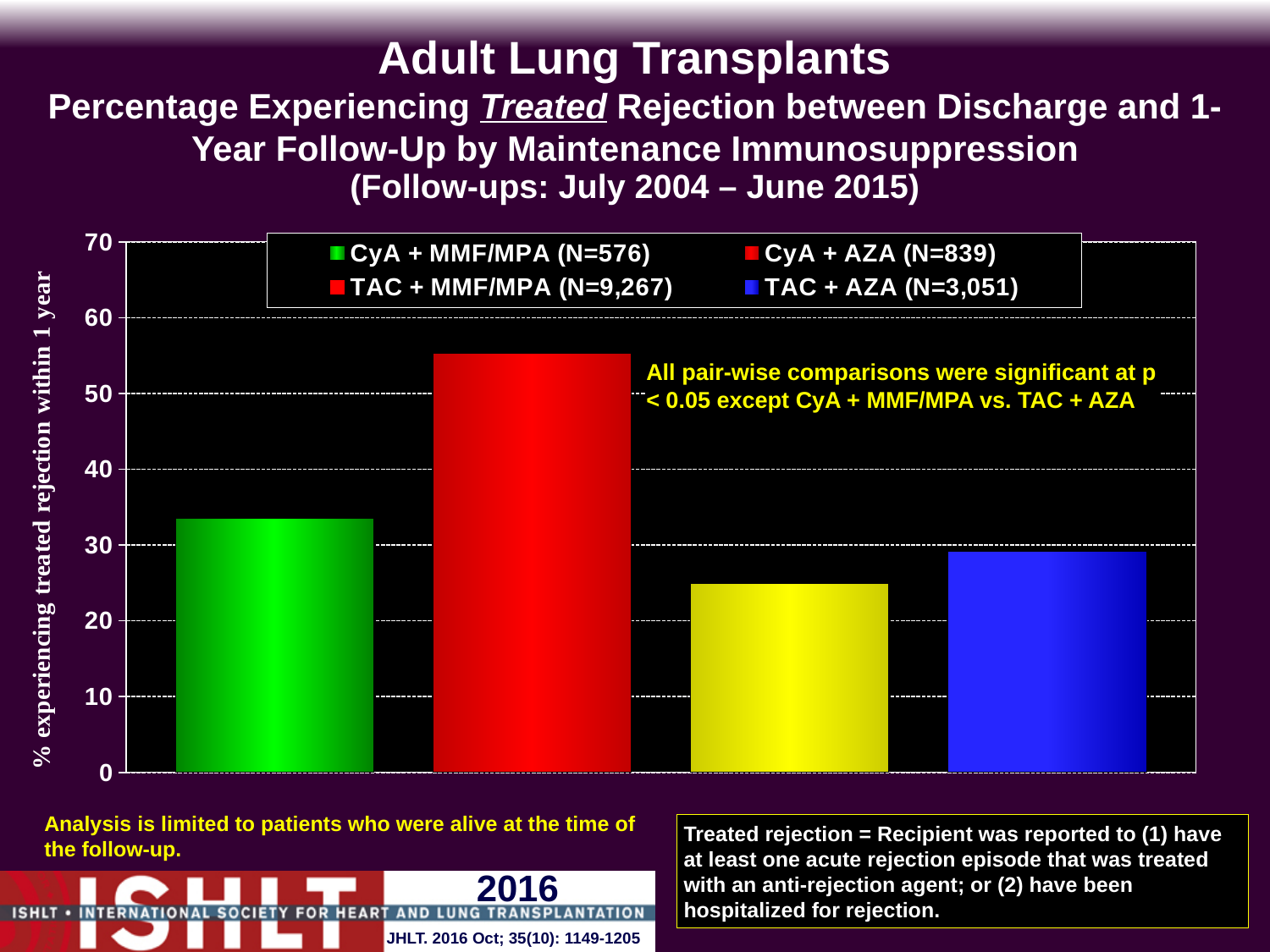
Which is larger, the value for CyA + MMF/MPA or the value for TAC + AZA? CyA + MMF/MPA Is the value for CyA + AZA greater or less than 50? greater How many series does the legend list? 4 How many bars are plotted in the chart? 4 Which immunosuppression group has the highest percentage experiencing treated rejection? CyA + AZA Is the value for CyA + MMF/MPA greater or less than 30? greater Which bar is the lowest in the chart? the yellow bar (third bar, TAC + MMF/MPA) What is the N shown in the legend for TAC + MMF/MPA? 9,267 Is the value for TAC + AZA greater or less than 30? less What is the label on the y axis of the chart? % experiencing treated rejection within 1 year What kind of chart is shown on the slide? bar chart